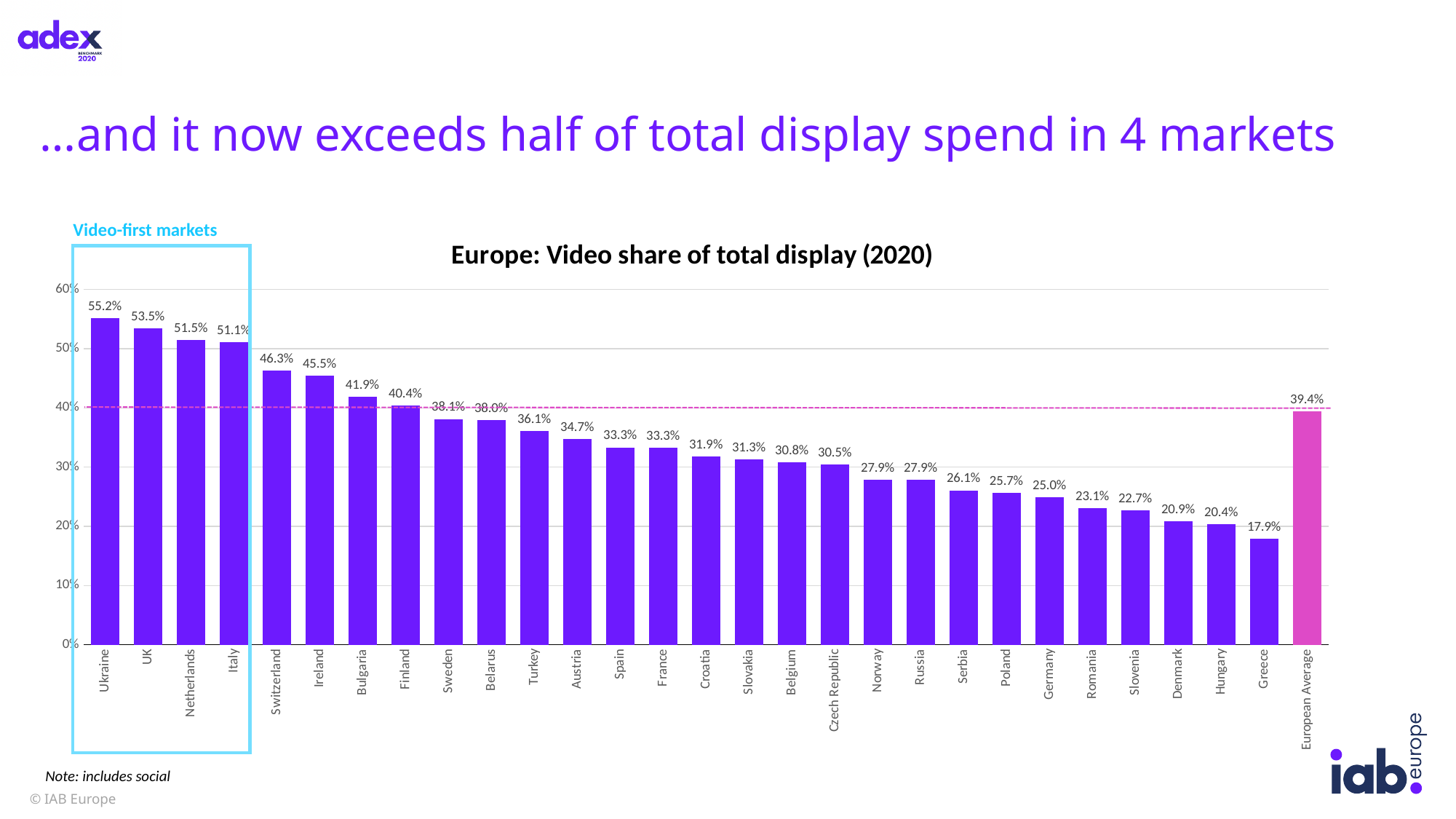
What is the value shown for the European Average bar? 39.4% Which has a higher video share of total display, Switzerland or Ireland? Switzerland What is the title of the chart? Europe: Video share of total display (2020) Which country has the lowest video share of total display? Greece How many bars are plotted in the chart, including the European Average? 29 What is the video share of total display for Ukraine? 55.2% What is the difference between the video share for Ukraine and the European Average? 15.8% What is the video share of total display for Germany? 25.0% Which country has the highest video share of total display? Ukraine Is the value for Finland greater or less than 40%? greater What is the difference between the video share for the UK and Italy? 2.4% What type of chart is shown on the slide? Bar chart